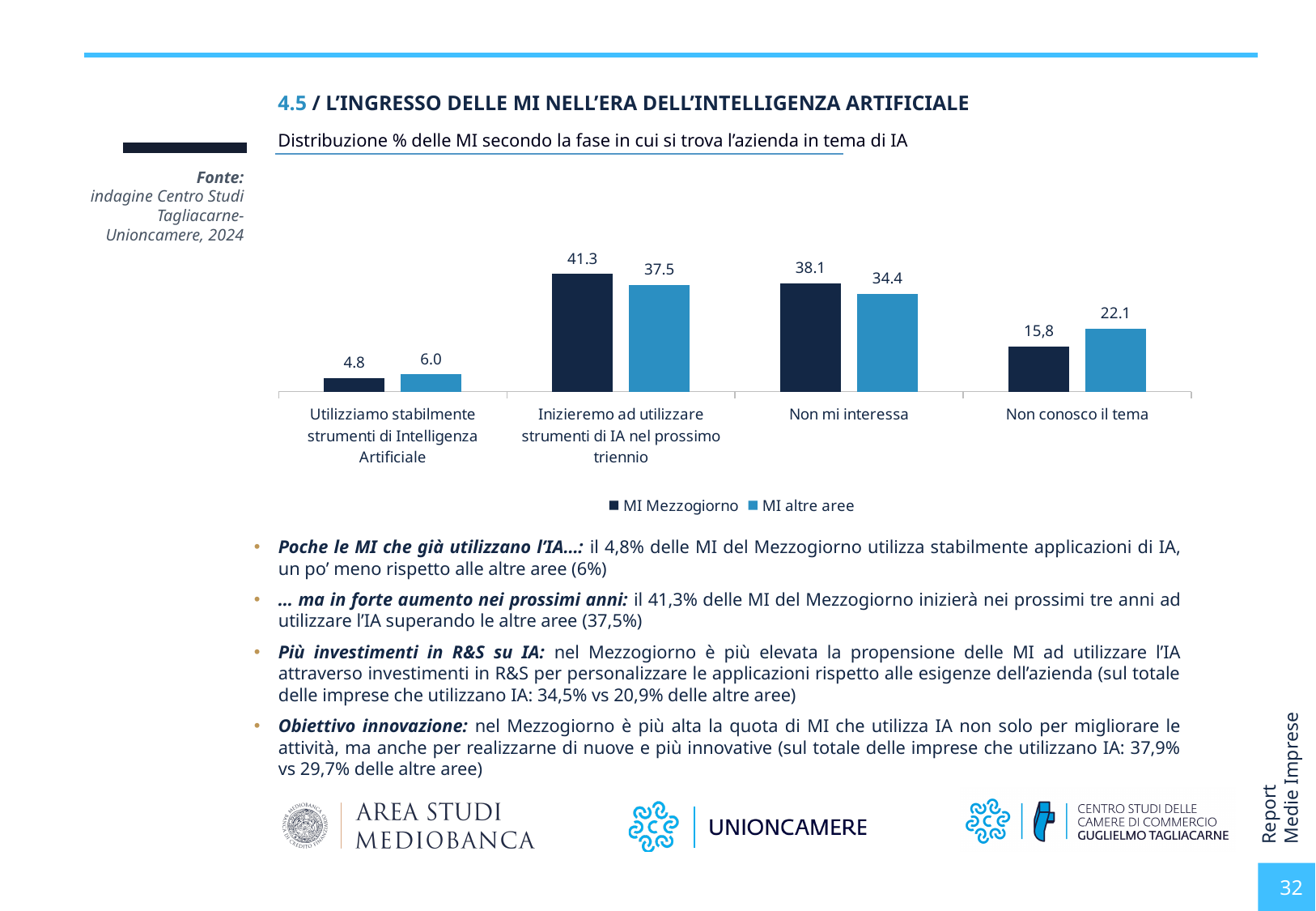
What is the value for MI altre aree in the category 'Inizieremo ad utilizzare strumenti di IA nel prossimo triennio'? 37.5 What is the value for MI altre aree in the category 'Non conosco il tema'? 22.1 How many categories are shown on the x axis? 4 Which series is shown in dark navy bars? MI Mezzogiorno What kind of chart is shown on the slide? bar chart In the category 'Non conosco il tema', which series has the larger value, MI Mezzogiorno or MI altre aree? MI altre aree What is the value for MI Mezzogiorno in the category 'Utilizziamo stabilmente strumenti di Intelligenza Artificiale'? 4.8 How many series does the legend list? 2 What is the value for MI Mezzogiorno in the category 'Non conosco il tema'? 15,8 Which category has the highest value for MI Mezzogiorno? Inizieremo ad utilizzare strumenti di IA nel prossimo triennio What is the difference between MI Mezzogiorno and MI altre aree in the category 'Non mi interessa'? 3.7 Which category has the lowest value for MI altre aree? Utilizziamo stabilmente strumenti di Intelligenza Artificiale